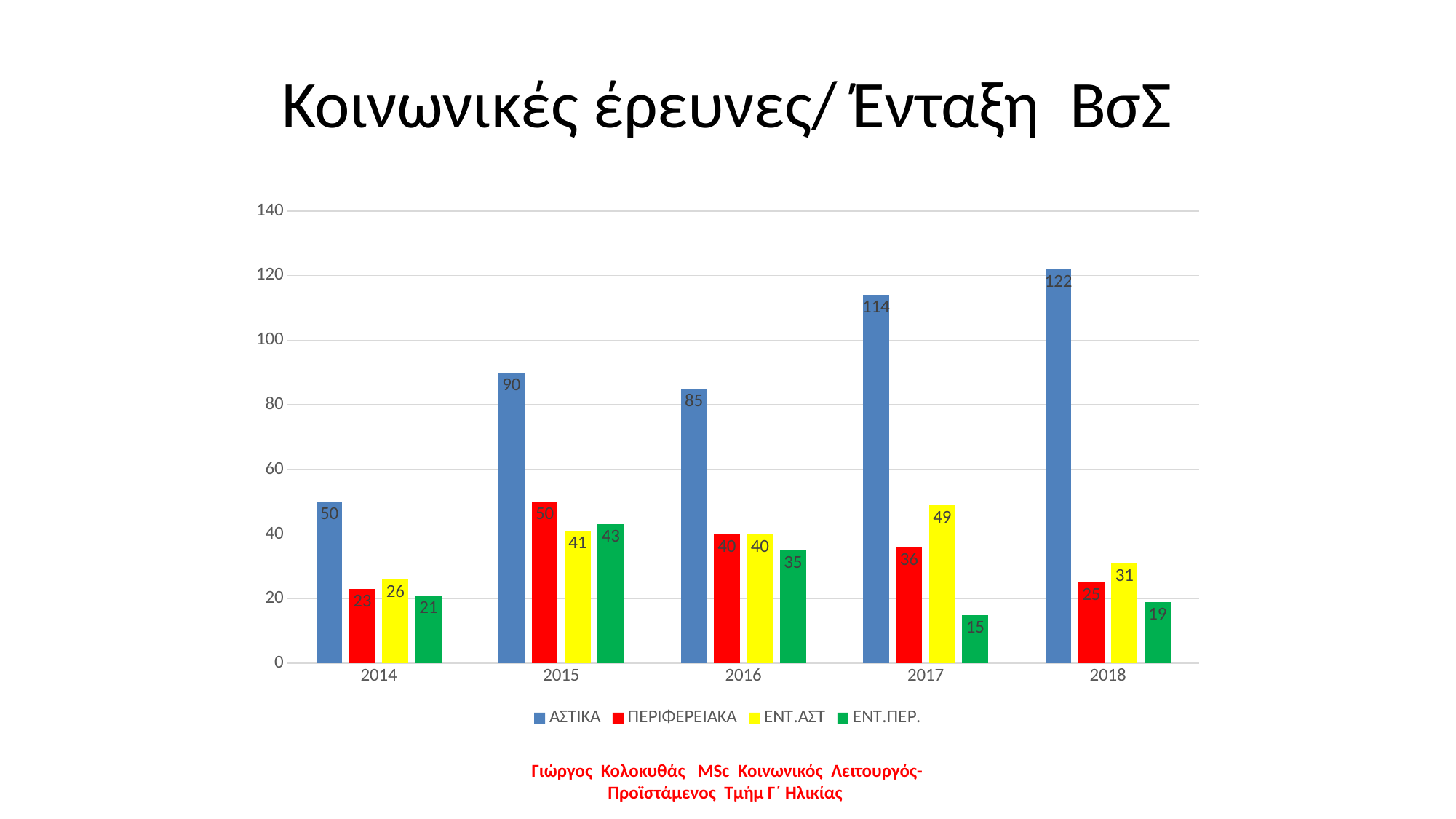
What is the value for ΑΣΤΙΚΑ in 2018? 122 What kind of chart is shown on the slide? Bar chart What is the difference between the ΑΣΤΙΚΑ values for 2018 and 2017? 8 What is the value for ΕΝΤ.ΑΣΤ in 2017? 49 What is the title of the chart on the slide? Κοινωνικές έρευνες/ Ένταξη ΒσΣ Which is larger in 2014: ΠΕΡΙΦΕΡΕΙΑΚΑ or ΕΝΤ.ΑΣΤ? ΕΝΤ.ΑΣΤ In which year is the ΑΣΤΙΚΑ value highest? 2018 How many series does the legend list? 4 How many years are shown on the x axis? 5 What is the value for ΠΕΡΙΦΕΡΕΙΑΚΑ in 2015? 50 In which year is the ΕΝΤ.ΠΕΡ. value lowest? 2017 What is the value for ΕΝΤ.ΠΕΡ. in 2016? 35